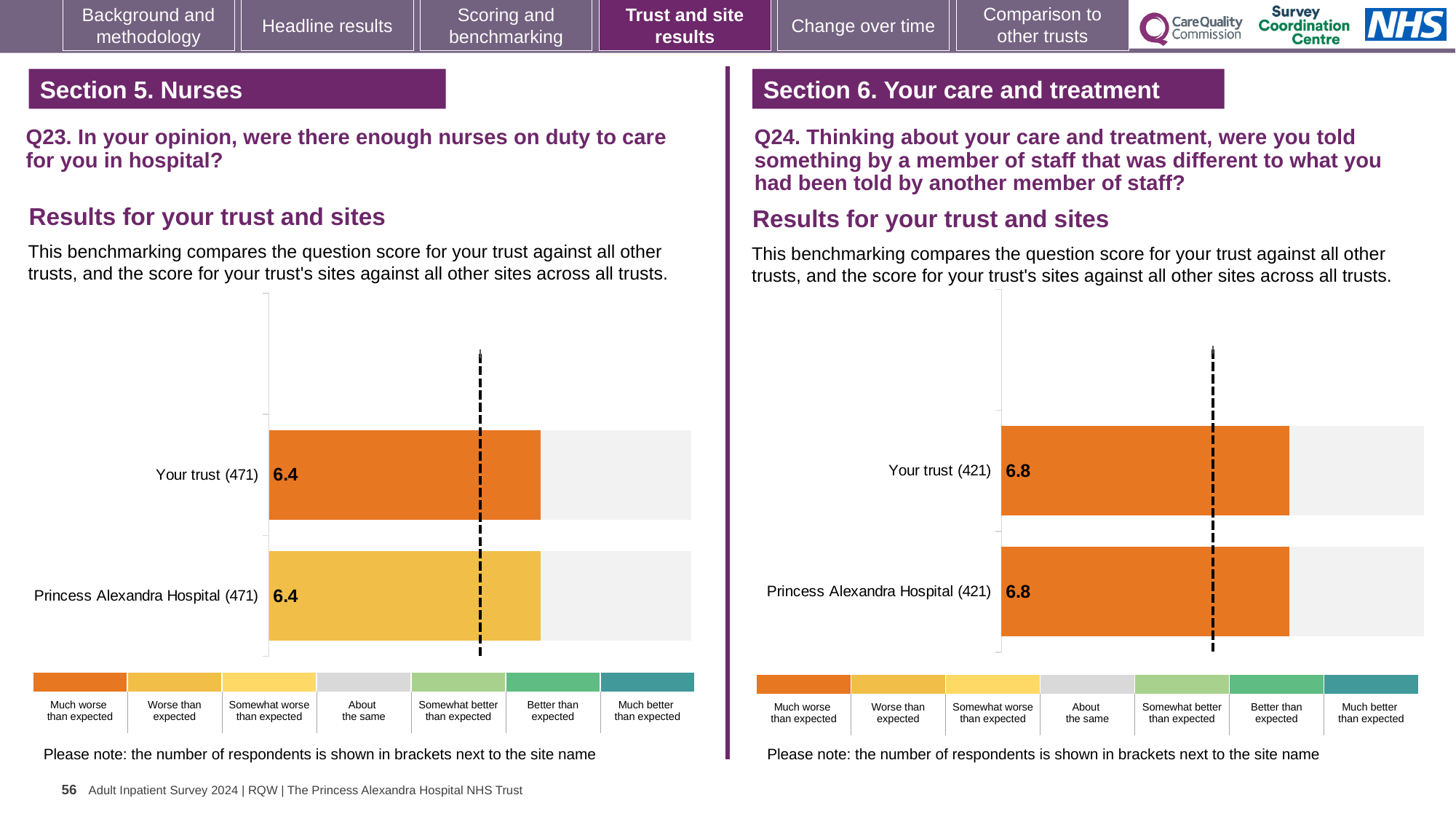
On the Q24 chart (right), which benchmark category does the colour of the Your trust bar correspond to? Much worse than expected What kind of chart is used for the Q23 results on the left? Bar chart How many bars are plotted on the Q24 chart (right)? 2 On the Q23 chart (left), what is the score for Your trust (471)? 6.4 On the Q23 chart (left), which benchmark category does the colour of the Princess Alexandra Hospital bar correspond to? Worse than expected On the Q24 chart (right), what is the score for Princess Alexandra Hospital (421)? 6.8 On the Q24 chart (right), what is the difference between the score for Your trust and the score for Princess Alexandra Hospital? 0.0 On the Q23 chart (left), what is the difference between the score for Your trust and the score for Princess Alexandra Hospital? 0.0 On the Q23 chart (left), what is the score for Princess Alexandra Hospital (471)? 6.4 On the Q24 chart (right), what is the score for Your trust (421)? 6.8 How many bars are plotted on the Q23 chart (left)? 2 How many respondents are shown in brackets for Your trust on the Q24 chart (right)? 421